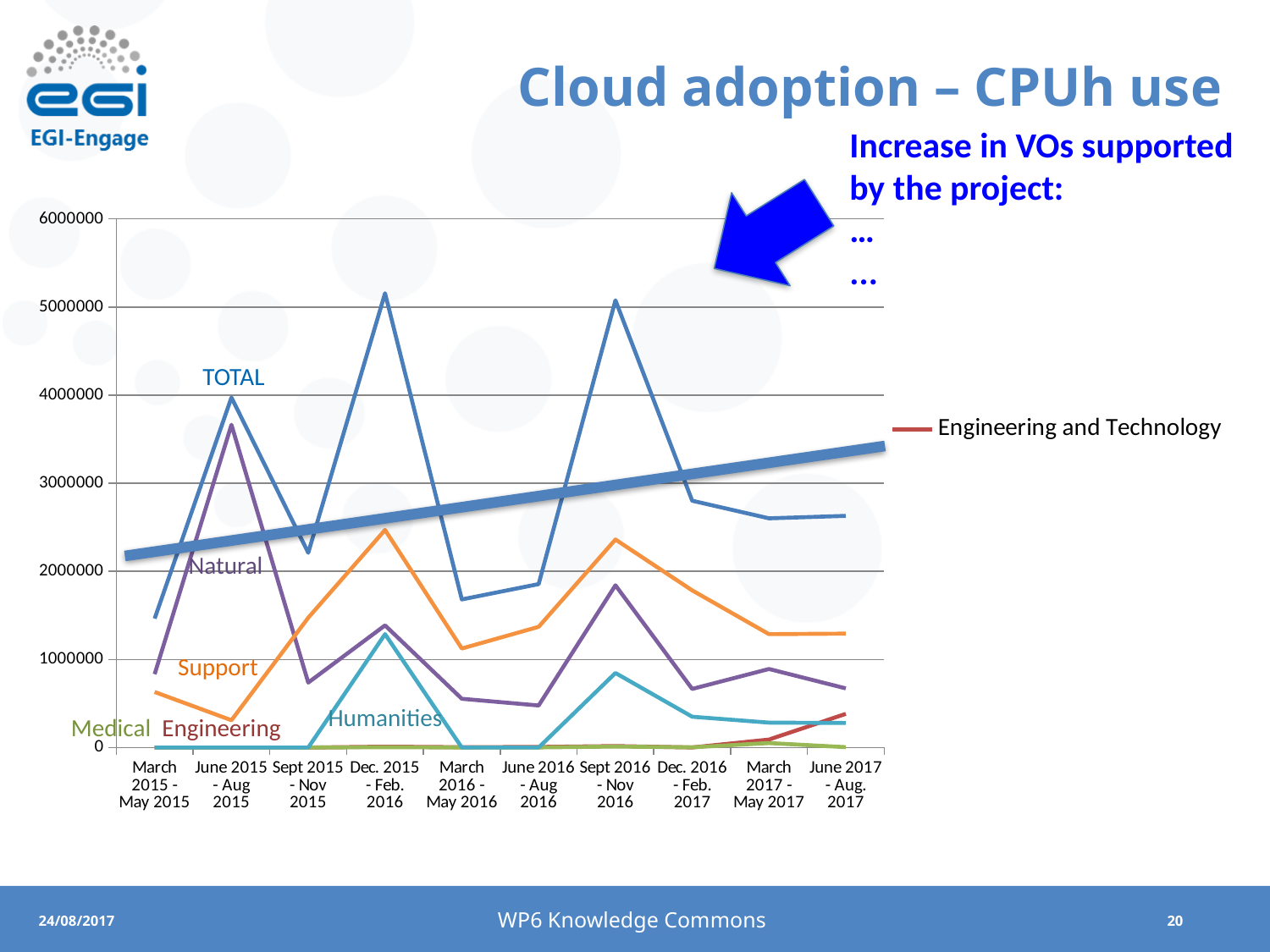
Does the Support series rise or fall from Sept 2016 - Nov 2016 to June 2017 - Aug. 2017? fall In which period does the Natural series reach its highest value? June 2015 - Aug 2015 Is the TOTAL value for March 2015 - May 2015 greater or less than 2000000? less Is the TOTAL value for Dec. 2015 - Feb. 2016 greater or less than 5000000? greater In June 2015 - Aug 2015, which is larger, TOTAL or Natural? TOTAL How many time periods are shown along the x axis? 10 Is the Natural value for June 2015 - Aug 2015 greater or less than 3000000? greater Which series name is shown in the legend to the right of the chart? Engineering and Technology What kind of chart is shown on the slide? line chart In Dec. 2015 - Feb. 2016, which is larger, Support or Natural? Support